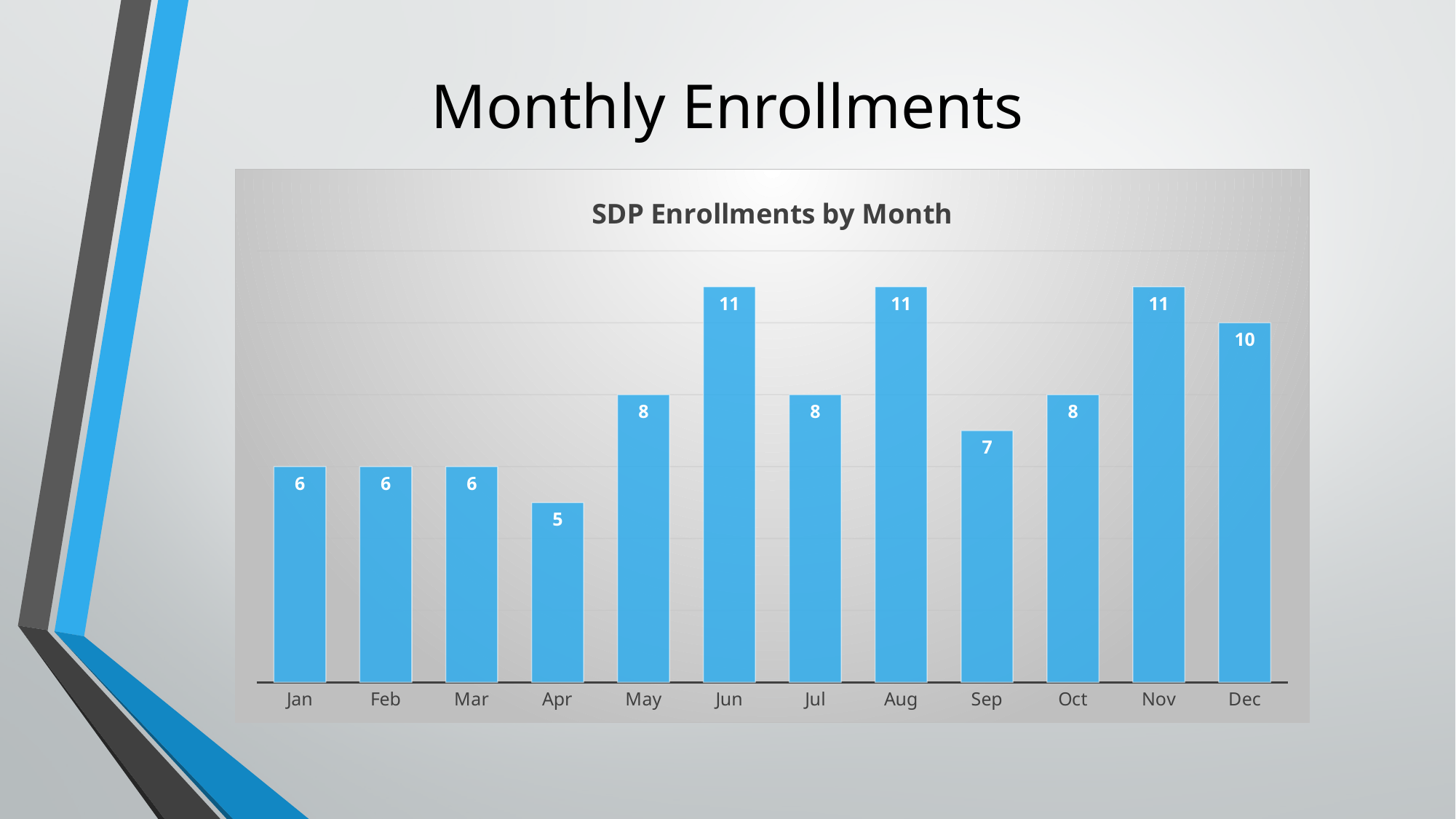
Which is larger in the SDP Enrollments by Month chart, the value for May or the value for Apr? May What is the value for Dec in the SDP Enrollments by Month chart? 10 Which month has the lowest value in the SDP Enrollments by Month chart? Apr What is the difference between the values for Aug and Sep in the SDP Enrollments by Month chart? 4 What is the title of the chart on the slide? SDP Enrollments by Month What is the value for Sep in the SDP Enrollments by Month chart? 7 Which is larger in the SDP Enrollments by Month chart, the value for Dec or the value for Oct? Dec What is the value for Apr in the SDP Enrollments by Month chart? 5 How many months are shown on the x axis of the SDP Enrollments by Month chart? 12 What is the value for Jun in the SDP Enrollments by Month chart? 11 What is the difference between the values for Nov and Dec in the SDP Enrollments by Month chart? 1 What kind of chart is the SDP Enrollments by Month chart? Bar chart